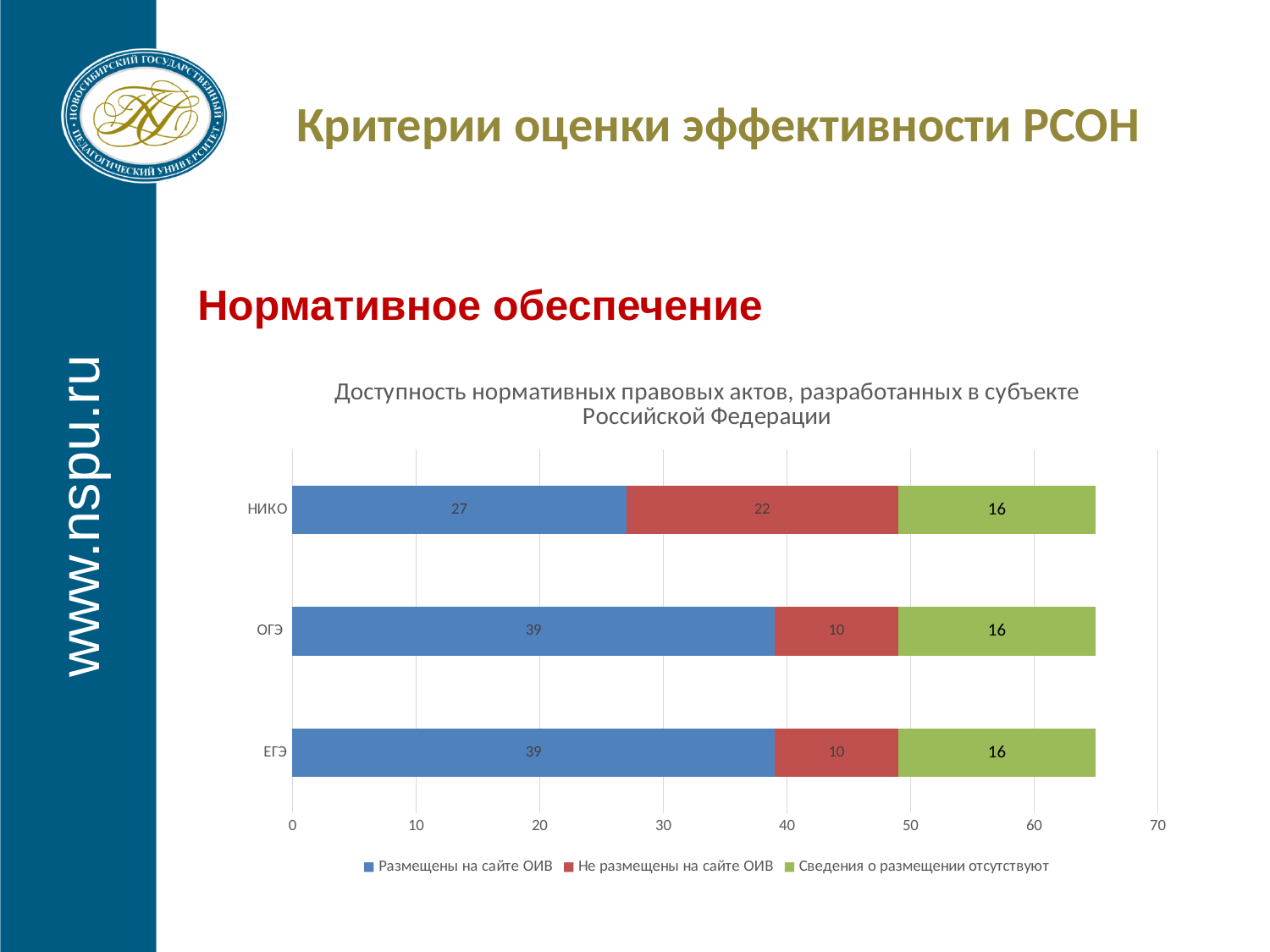
What is the difference between the "Размещены на сайте ОИВ" values for ОГЭ and НИКО? 12 What is the value for "Размещены на сайте ОИВ" for НИКО? 27 What is the value for "Сведения о размещении отсутствуют" for ЕГЭ? 16 What is the total of the stacked bar for НИКО? 65 What is the value for "Не размещены на сайте ОИВ" for ОГЭ? 10 Which category has the lowest value for "Размещены на сайте ОИВ"? НИКО Which is larger: the "Не размещены на сайте ОИВ" value for НИКО or for ЕГЭ? НИКО What kind of chart is shown on the slide? Stacked bar chart What is the title of the chart? Доступность нормативных правовых актов, разработанных в субъекте Российской Федерации How many categories are shown on the chart? 3 How many series does the legend list? 3 Which category has the highest value for "Не размещены на сайте ОИВ"? НИКО